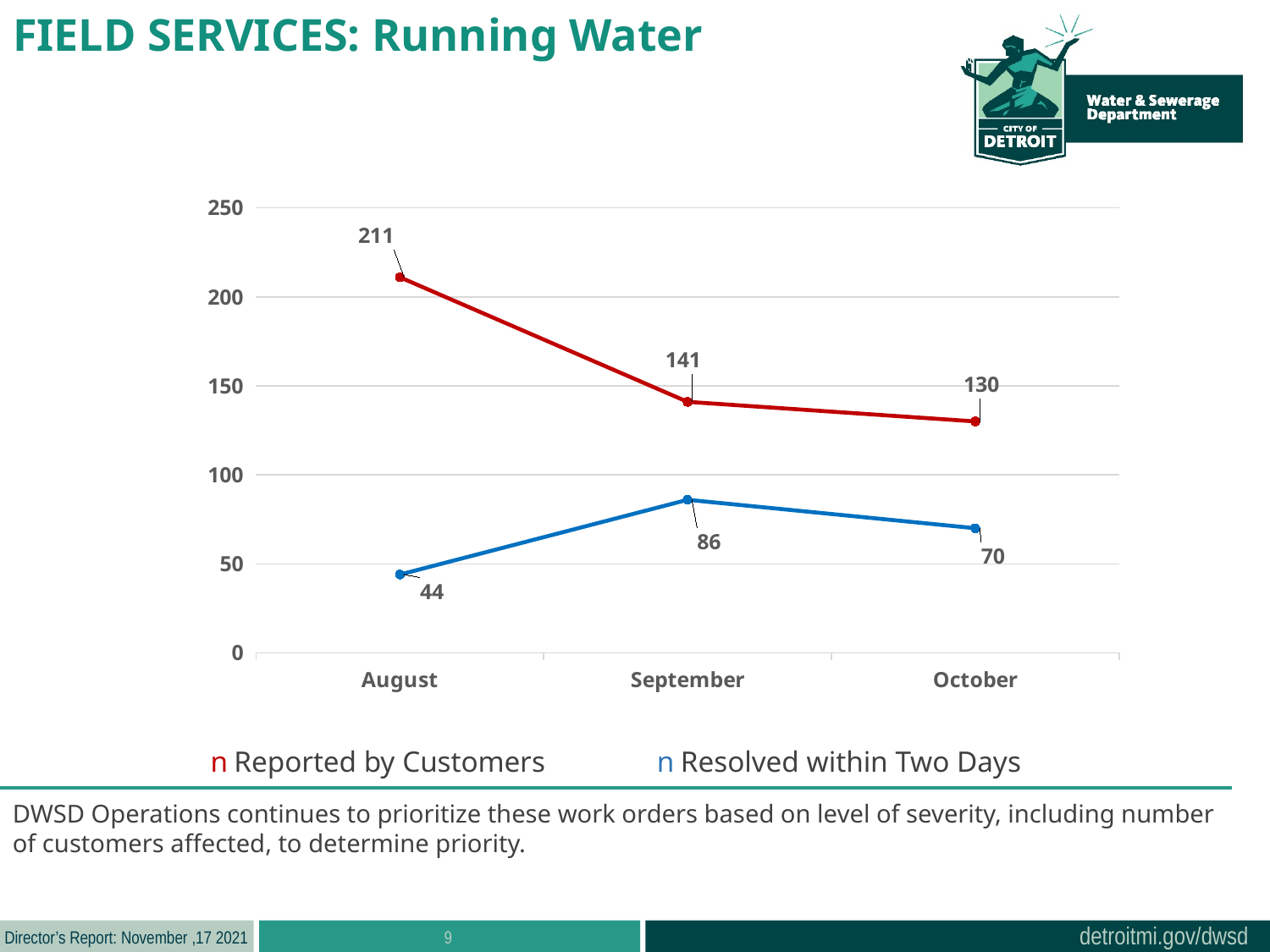
What is the difference between Reported by Customers and Resolved within Two Days in September? 55 How many months are shown on the x axis? 3 Which is larger in October: Reported by Customers or Resolved within Two Days? Reported by Customers What is the value for Reported by Customers in October? 130 What is the value for Resolved within Two Days in September? 86 Does Reported by Customers rise or fall from August to October? Fall What is the value for Reported by Customers in August? 211 How many series does the legend list? 2 What kind of chart is shown on the slide? Line chart What colour is the line for Resolved within Two Days? Blue In which month is Reported by Customers highest? August In which month is Resolved within Two Days lowest? August